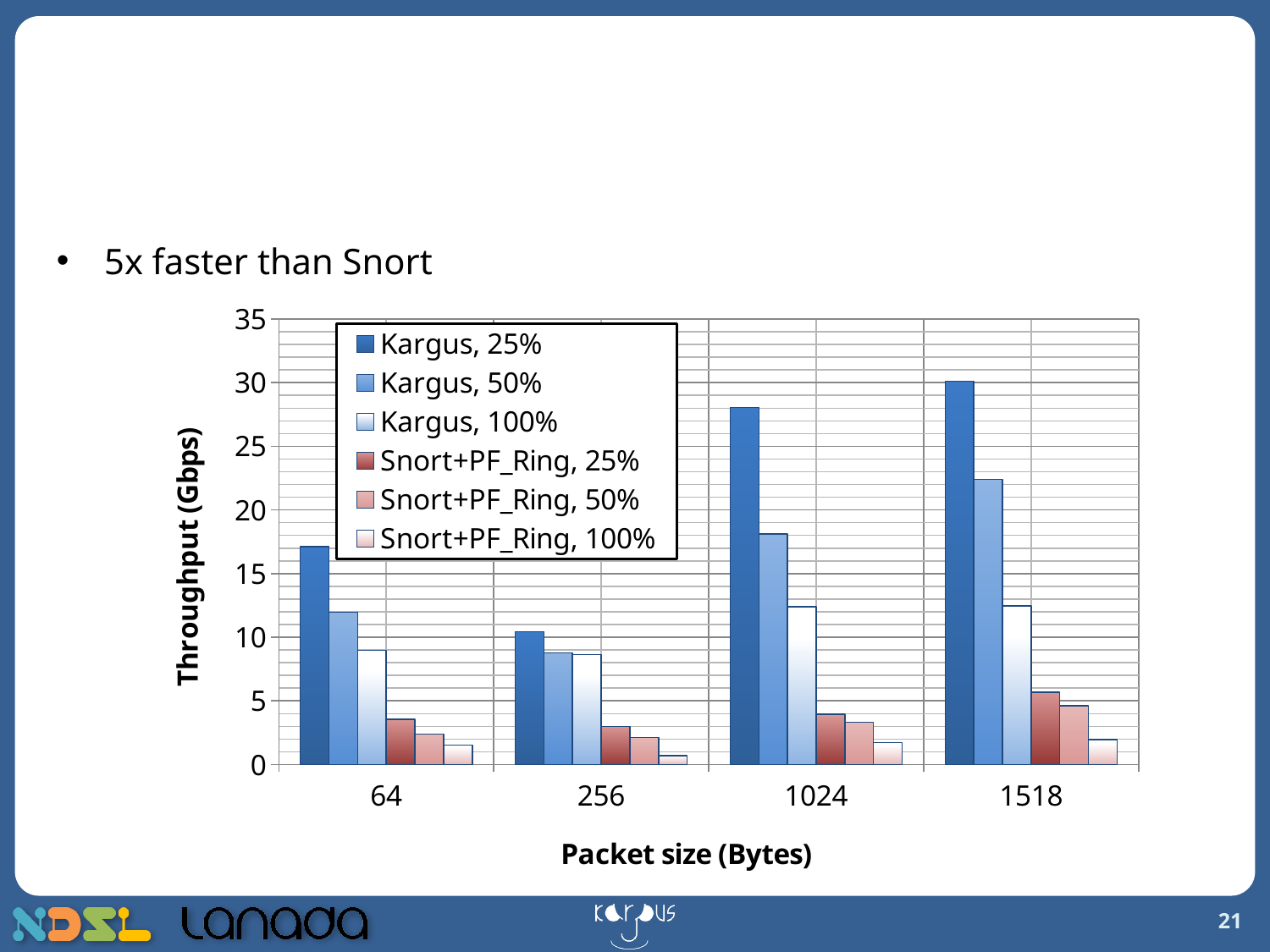
For which packet size is the Kargus, 25% throughput lowest? 256 Is the Kargus, 25% value at packet size 1024 greater or less than 25? greater What is the label of the y axis? Throughput (Gbps) Is the Kargus, 50% value at packet size 1518 greater or less than 20? greater How many series does the legend list? 6 At packet size 1024, which is larger, Kargus, 50% or Kargus, 100%? Kargus, 50% Is the Snort+PF_Ring, 100% value at packet size 256 greater or less than 5? less What kind of chart is shown on the slide? bar chart Which packet size has the larger Kargus, 25% throughput, 64 or 256? 64 How many packet sizes are shown on the x axis? 4 What is the label of the x axis? Packet size (Bytes) For which packet size is the Kargus, 25% throughput highest? 1518